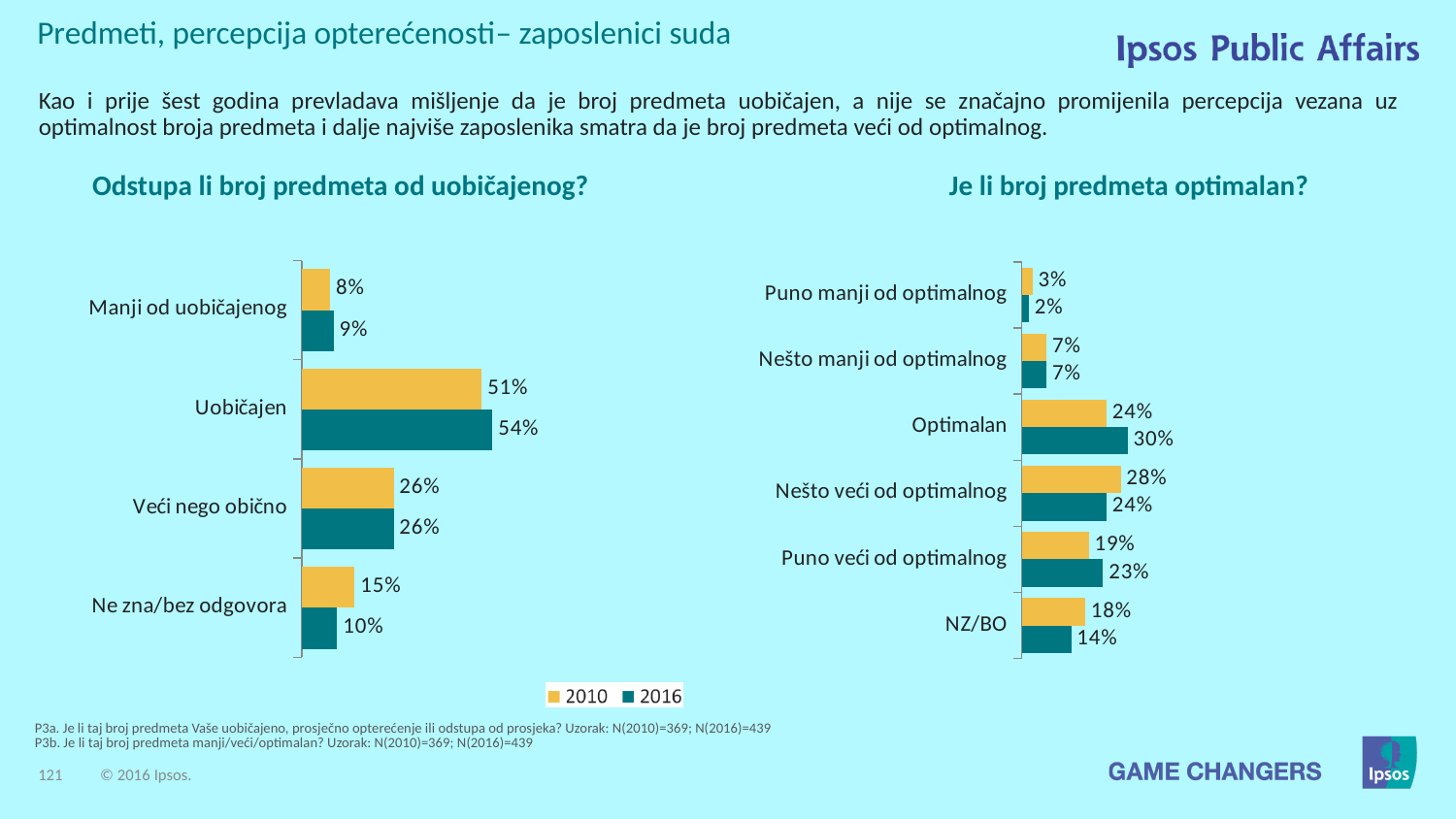
In the chart 'Odstupa li broj predmeta od uobičajenog?', what is the 2010 value for 'Ne zna/bez odgovora'? 15% In the chart 'Je li broj predmeta optimalan?', which category has the highest 2010 value? Nešto veći od optimalnog In the chart 'Je li broj predmeta optimalan?', what is the 2010 value for 'Puno veći od optimalnog'? 19% In the chart 'Odstupa li broj predmeta od uobičajenog?', what is the difference between the 2016 and 2010 values for 'Uobičajen'? 3% In the chart 'Je li broj predmeta optimalan?', which category has the lowest 2016 value? Puno manji od optimalnog In the chart 'Odstupa li broj predmeta od uobičajenog?', which category has the highest 2010 value? Uobičajen In the chart 'Je li broj predmeta optimalan?', is the 2010 value for 'NZ/BO' larger or the 2016 value? 2010 In the chart 'Odstupa li broj predmeta od uobičajenog?', how many categories are shown? 4 How many series does the legend list for the charts on the slide? 2 In the chart 'Je li broj predmeta optimalan?', what is the 2016 value for 'Optimalan'? 30% In the chart 'Je li broj predmeta optimalan?', how many categories are shown? 6 In the chart 'Odstupa li broj predmeta od uobičajenog?', what is the 2016 value for 'Uobičajen'? 54%